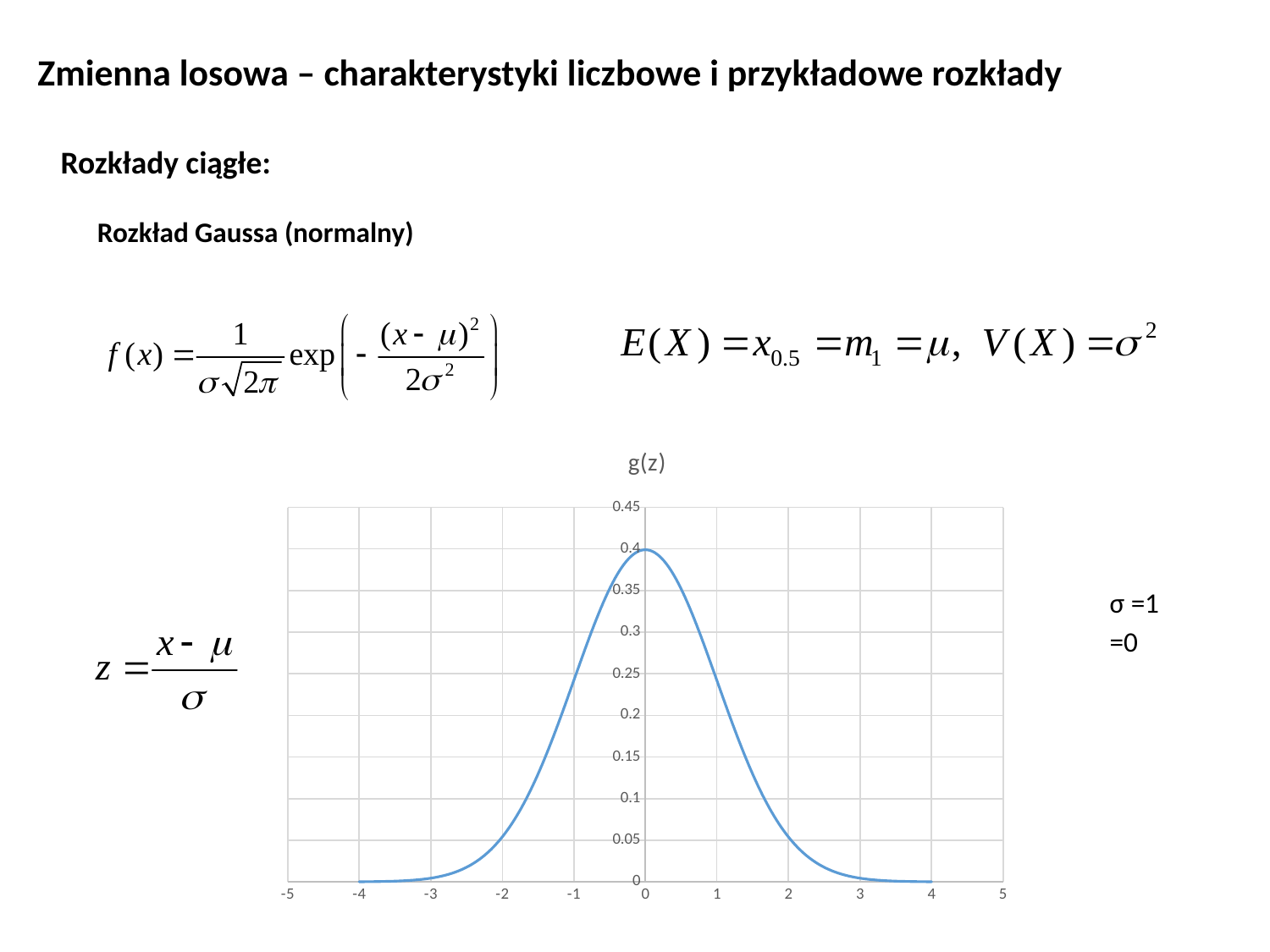
What is the title of the chart? g(z) At which value of z does the curve reach its highest point? 0 Is the value of the curve at z = 1 greater or less than 0.2? greater Does the curve rise or fall as z goes from 0 to 4? fall Is the value of the curve at z = 0 greater or less than 0.35? greater Is the value of the curve at z = 2 greater or less than 0.1? less What kind of chart is shown on the slide? line chart Does the curve rise or fall as z goes from -4 to 0? rise Which is larger, the value of the curve at z = 1 or at z = 2? z = 1 What is the highest value shown on the vertical axis? 0.45